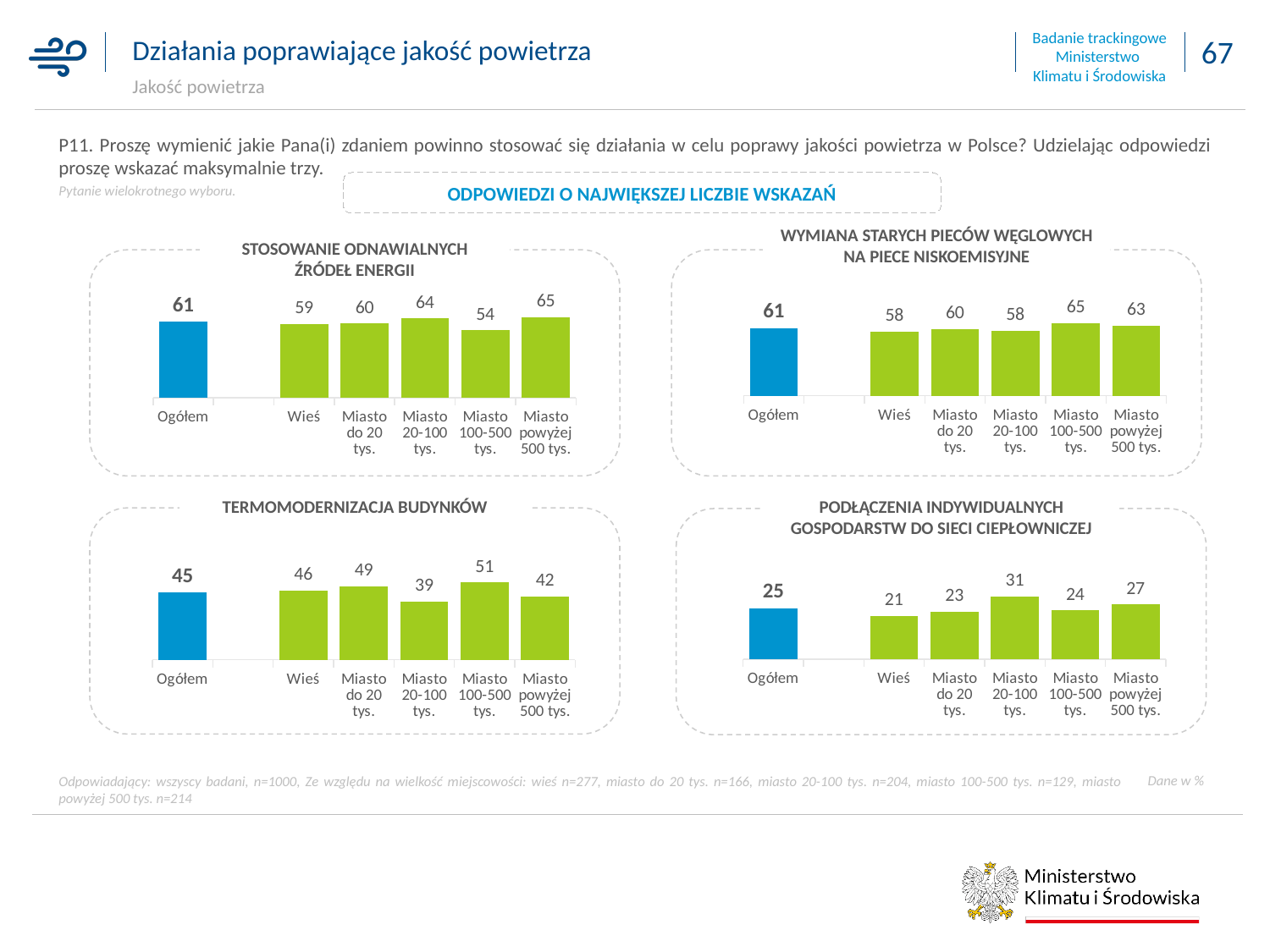
In the chart titled 'PODŁĄCZENIA INDYWIDUALNYCH GOSPODARSTW DO SIECI CIEPŁOWNICZEJ', which category has the highest value? Miasto 20-100 tys. What kind of chart is the chart titled 'TERMOMODERNIZACJA BUDYNKÓW'? Bar chart In the chart titled 'TERMOMODERNIZACJA BUDYNKÓW', what is the value for Miasto 20-100 tys.? 39 In the chart titled 'TERMOMODERNIZACJA BUDYNKÓW', which is larger: the value for Wieś or the value for Miasto powyżej 500 tys.? Wieś In the chart titled 'TERMOMODERNIZACJA BUDYNKÓW', what is the difference between the values for Miasto 100-500 tys. and Ogółem? 6 In the chart titled 'WYMIANA STARYCH PIECÓW WĘGLOWYCH NA PIECE NISKOEMISYJNE', what is the value for Miasto 100-500 tys.? 65 In the chart titled 'WYMIANA STARYCH PIECÓW WĘGLOWYCH NA PIECE NISKOEMISYJNE', how many categories are shown on the x axis? 6 In the chart titled 'STOSOWANIE ODNAWIALNYCH ŹRÓDEŁ ENERGII', what is the value for Ogółem? 61 In the chart titled 'STOSOWANIE ODNAWIALNYCH ŹRÓDEŁ ENERGII', what is the difference between the values for Miasto powyżej 500 tys. and Miasto 100-500 tys.? 11 In the chart titled 'WYMIANA STARYCH PIECÓW WĘGLOWYCH NA PIECE NISKOEMISYJNE', which category has the highest value? Miasto 100-500 tys. In the chart titled 'STOSOWANIE ODNAWIALNYCH ŹRÓDEŁ ENERGII', which category has the lowest value? Miasto 100-500 tys. In the chart titled 'PODŁĄCZENIA INDYWIDUALNYCH GOSPODARSTW DO SIECI CIEPŁOWNICZEJ', what is the value for Wieś? 21